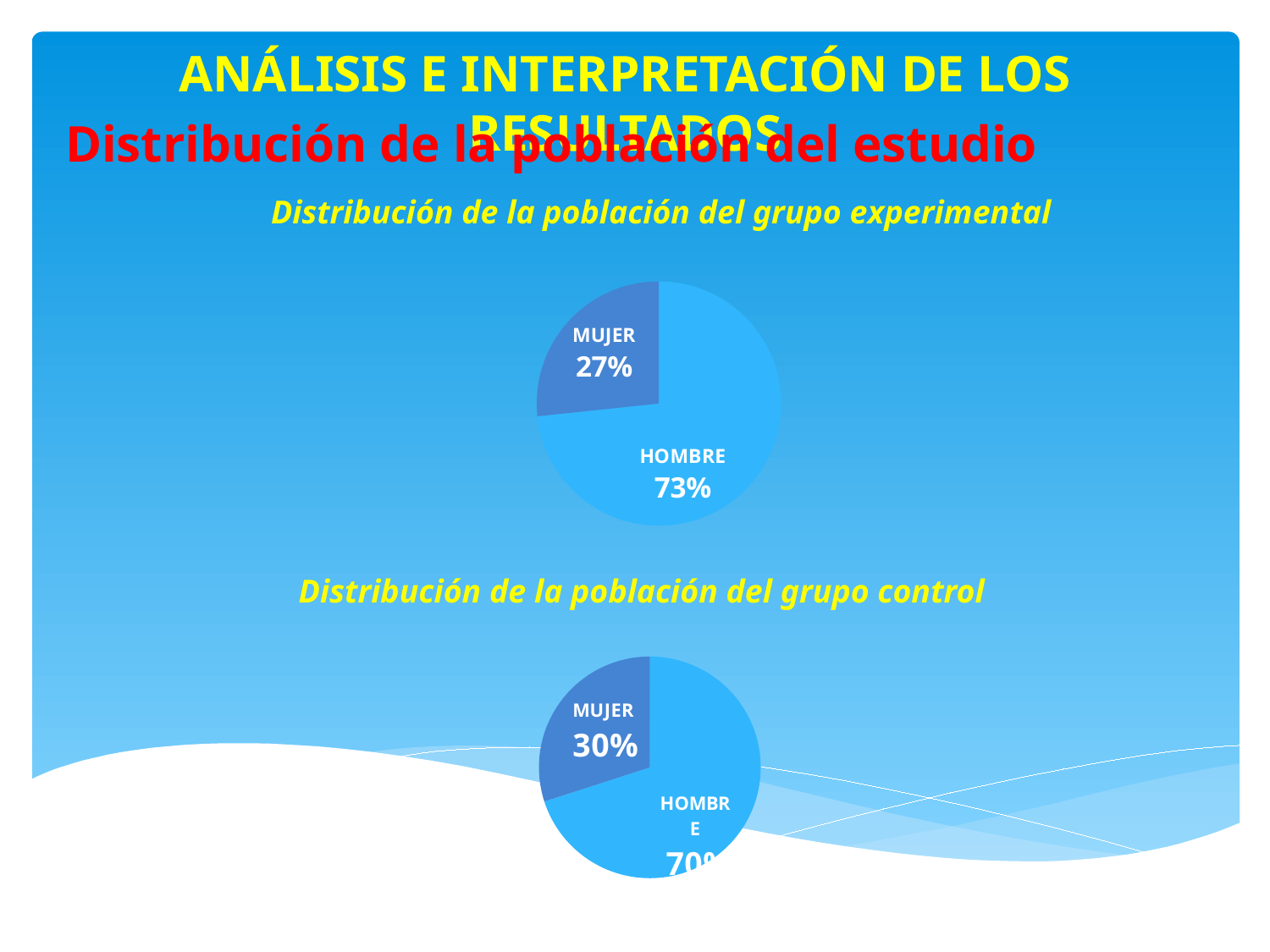
In the 'Distribución de la población del grupo control' chart, which category has the smallest share? MUJER In the 'Distribución de la población del grupo experimental' chart, what percentage is HOMBRE? 73% In the 'Distribución de la población del grupo experimental' chart, which category has the largest share? HOMBRE How many categories are shown in the 'Distribución de la población del grupo control' chart? 2 What type of chart is the 'Distribución de la población del grupo experimental' chart? pie chart In the 'Distribución de la población del grupo experimental' chart, what percentage is MUJER? 27% In the 'Distribución de la población del grupo experimental' chart, what is the difference between the HOMBRE and MUJER percentages? 46% How many pie charts are shown on the slide? 2 In the 'Distribución de la población del grupo control' chart, what percentage is MUJER? 30% In the 'Distribución de la población del grupo control' chart, what is the difference between the HOMBRE and MUJER percentages? 40% In the 'Distribución de la población del grupo control' chart, what percentage is HOMBRE? 70% Which chart has a larger MUJER share, the grupo experimental chart or the grupo control chart? grupo control